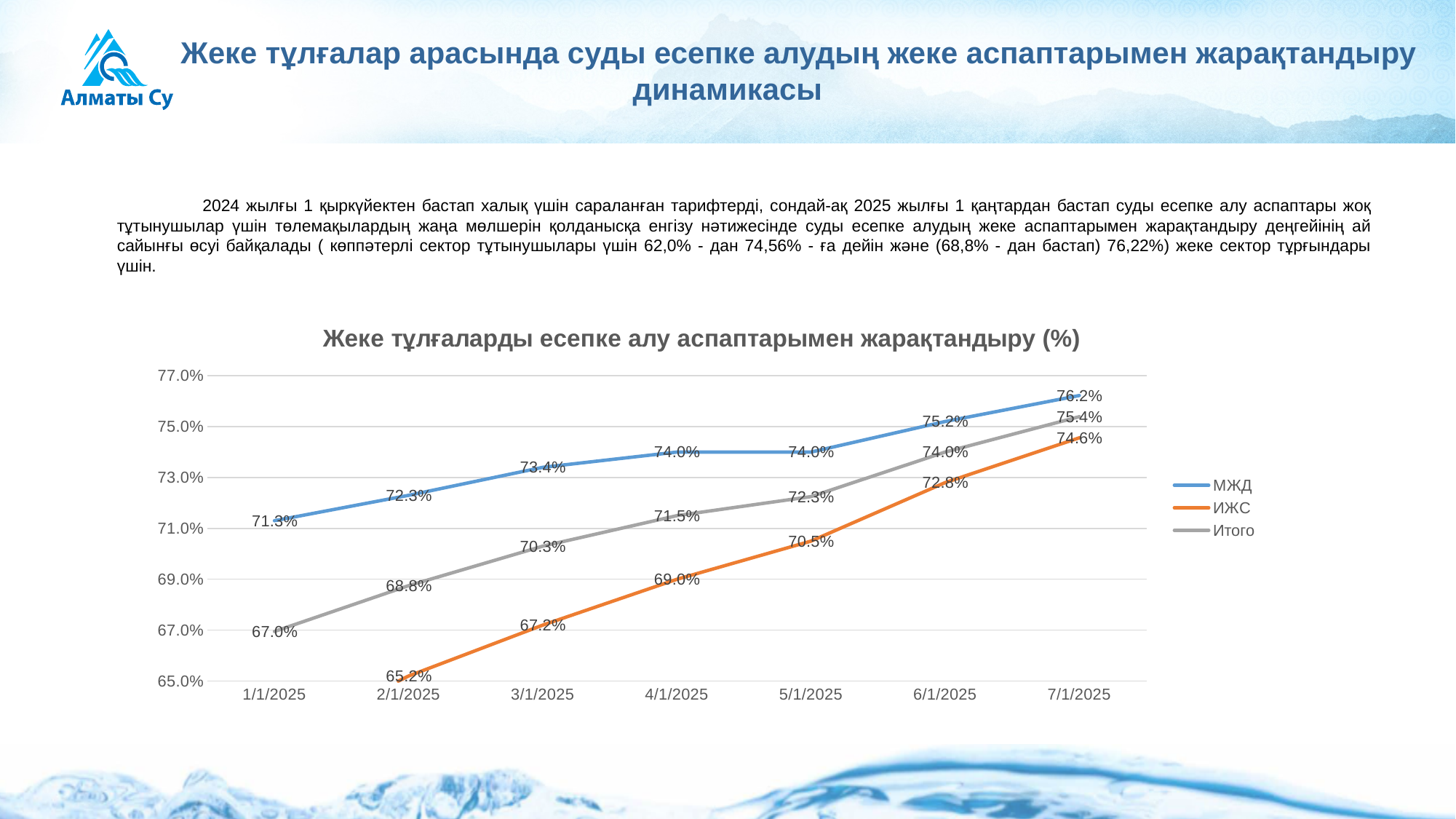
At which date is the Итого series lowest? 1/1/2025 How many series does the legend list? 3 What is the value for ИЖС at 7/1/2025? 74.6% At which date is the МЖД series highest? 7/1/2025 How many dates are shown on the x axis? 7 What is the value for ИЖС at 2/1/2025? 65.2% What is the value for МЖД at 1/1/2025? 71.3% Which is larger at 6/1/2025, МЖД or Итого? МЖД Does the Итого series rise or fall from 1/1/2025 to 7/1/2025? rise What type of chart is shown on the slide? line chart What is the difference between МЖД and ИЖС at 7/1/2025? 1.6% What is the value for Итого at 4/1/2025? 71.5%